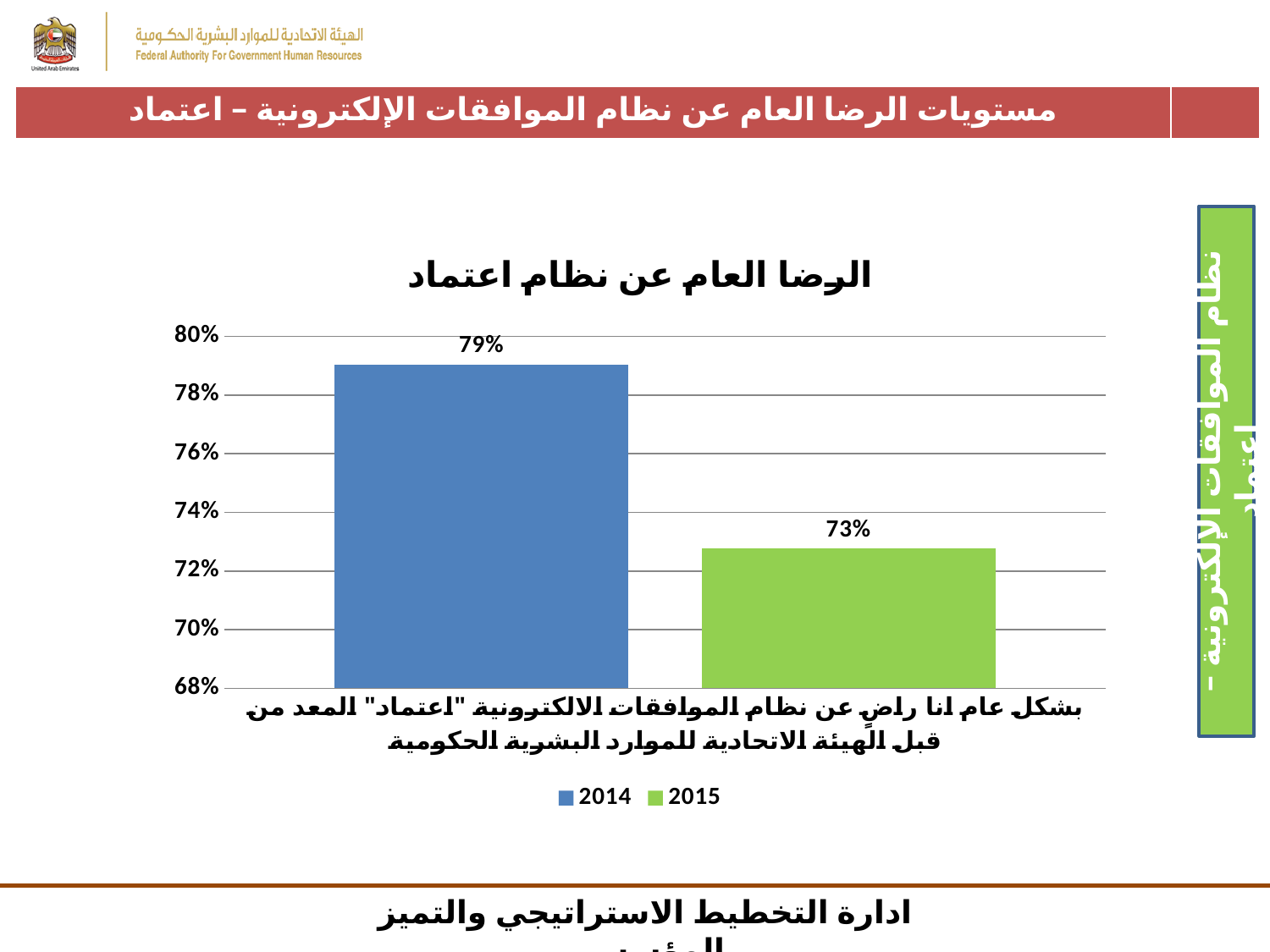
What is the value for 2014? 79% What kind of chart is shown on the slide? bar chart Which series has the higher value, 2014 or 2015? 2014 How many series does the legend list? 2 What is the value for 2015? 73% What is the title of the chart? الرضا العام عن نظام اعتماد Which series has the lowest value? 2015 Is the value for 2014 greater or less than 78%? greater Is the value for 2015 greater or less than 74%? less What colour is the bar for 2015? green What is the difference between the 2014 and 2015 values? 6% Does the value rise or fall from 2014 to 2015? fall